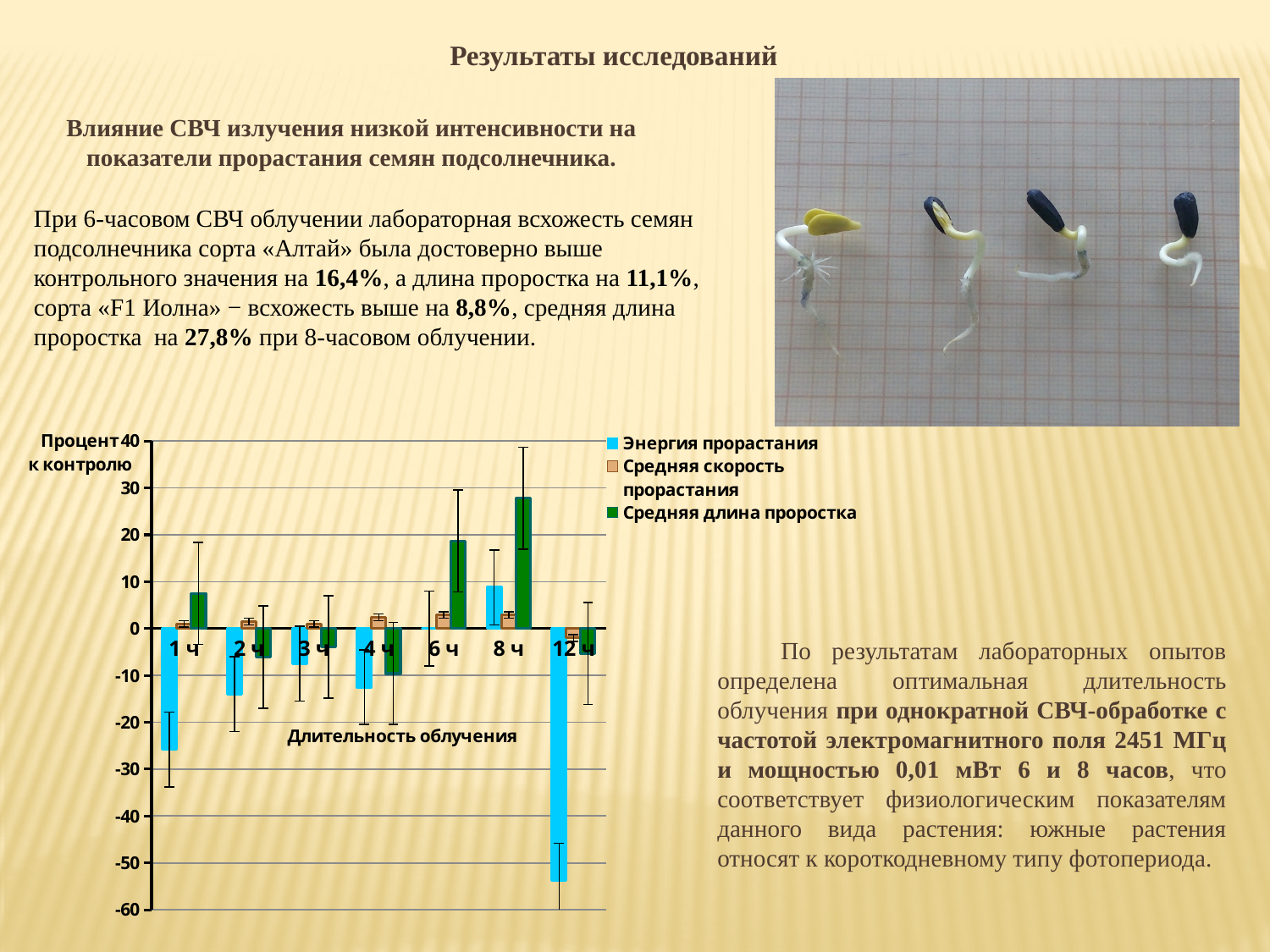
Is the value of Энергия прорастания for 12 ч greater or less than -40? less For which irradiation duration is Энергия прорастания lowest? 12 ч Which is larger, Средняя длина проростка for 8 ч or for 1 ч? 8 ч Is the value of Энергия прорастания for 1 ч greater or less than -20? less What is the title of the x axis of the chart? Длительность облучения Is the value of Средняя длина проростка for 6 ч greater or less than 10? greater For which irradiation duration is Средняя длина проростка highest? 8 ч How many irradiation duration categories are shown on the x axis of the chart? 7 Which series is shown in green in the chart? Средняя длина проростка What kind of chart is shown on the slide? bar chart How many series does the chart legend list? 3